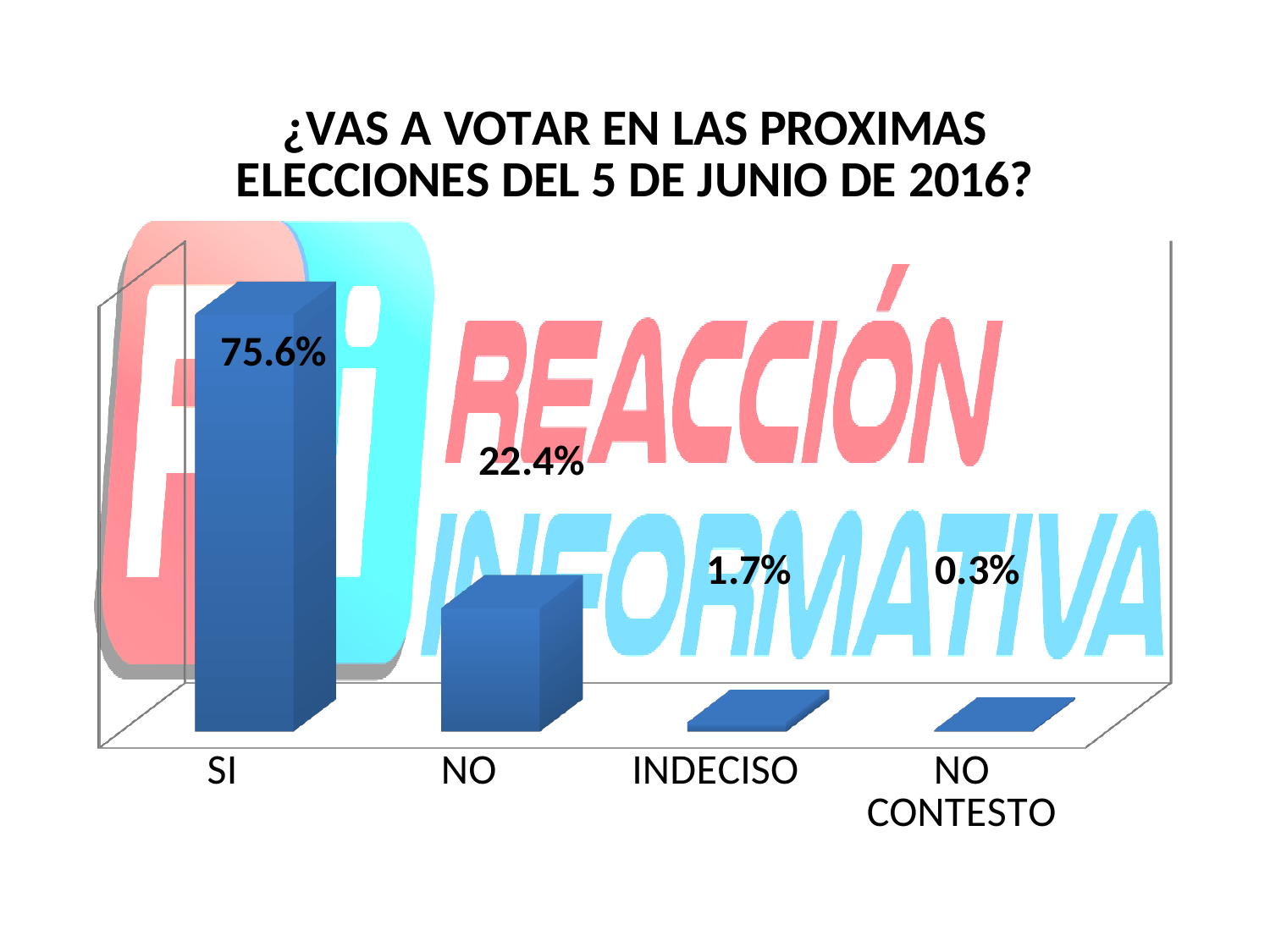
What is the value for SI? 75.6% What is the title of the chart? ¿VAS A VOTAR EN LAS PROXIMAS ELECCIONES DEL 5 DE JUNIO DE 2016? What kind of chart is shown on the slide? Bar chart What is the value for INDECISO? 1.7% What is the difference between the values for INDECISO and NO CONTESTO? 1.4% Which is larger, the value for NO or the value for INDECISO? NO What is the difference between the values for SI and NO? 53.2% What is the value for NO? 22.4% How many categories are shown on the x axis? 4 Which category has the highest value? SI Which category has the lowest value? NO CONTESTO What is the value for NO CONTESTO? 0.3%